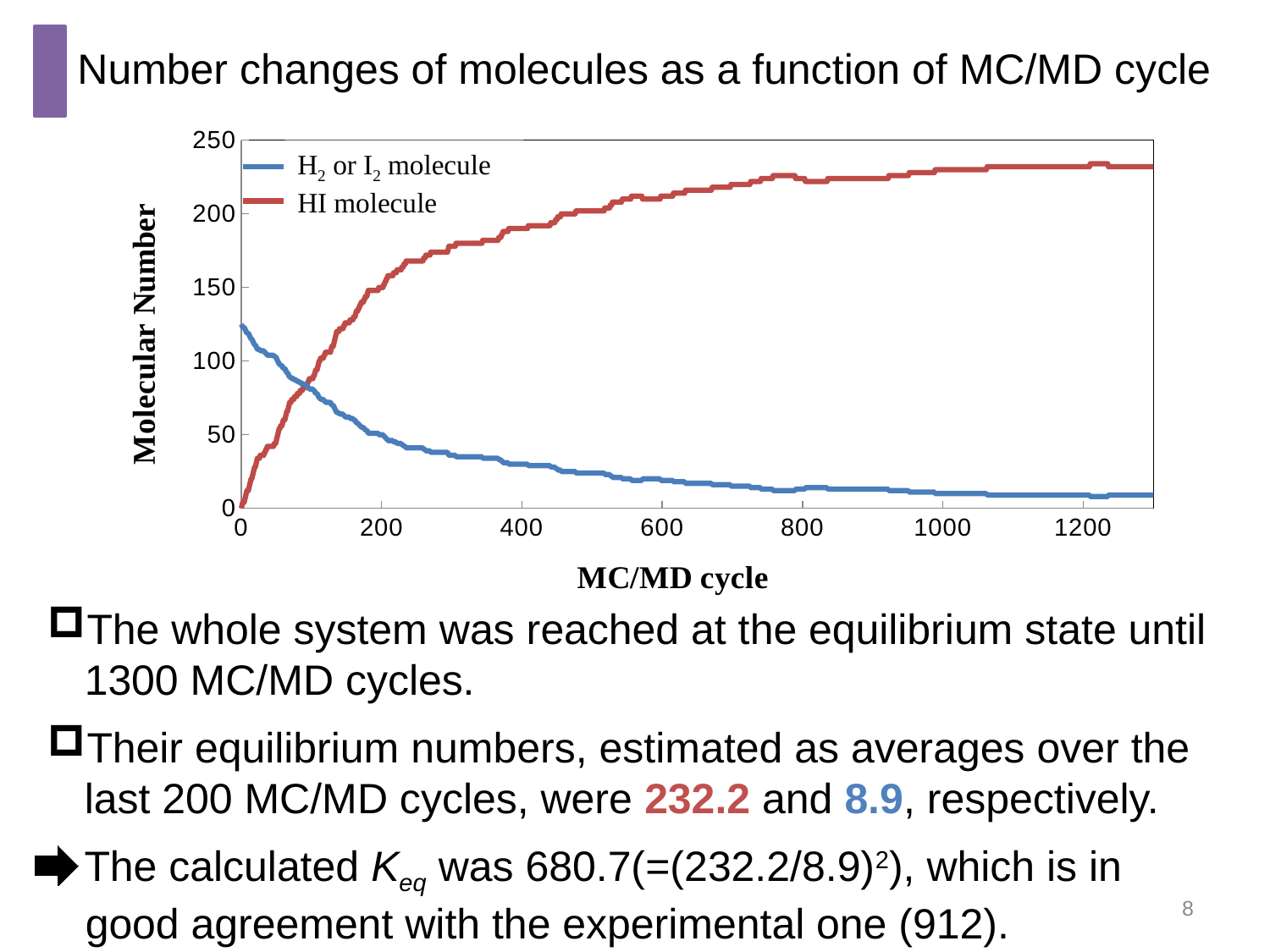
Is the value for H2 or I2 molecule at MC/MD cycle 1200 greater or less than 50? less Which colour is used for the HI molecule series in the chart? red Does the number of HI molecules rise or fall as the MC/MD cycle increases? rise How many series does the chart's legend list? 2 Does the number of H2 or I2 molecules rise or fall as the MC/MD cycle increases? fall At MC/MD cycle 1000, which series has the larger value, HI molecule or H2 or I2 molecule? HI molecule What kind of chart is shown on the slide? line chart Is the value for HI molecule at MC/MD cycle 200 greater or less than 100? greater What is the label of the chart's y axis? Molecular Number Is the value for HI molecule at MC/MD cycle 1200 greater or less than 200? greater At MC/MD cycle 0, which series has the larger value, HI molecule or H2 or I2 molecule? H2 or I2 molecule